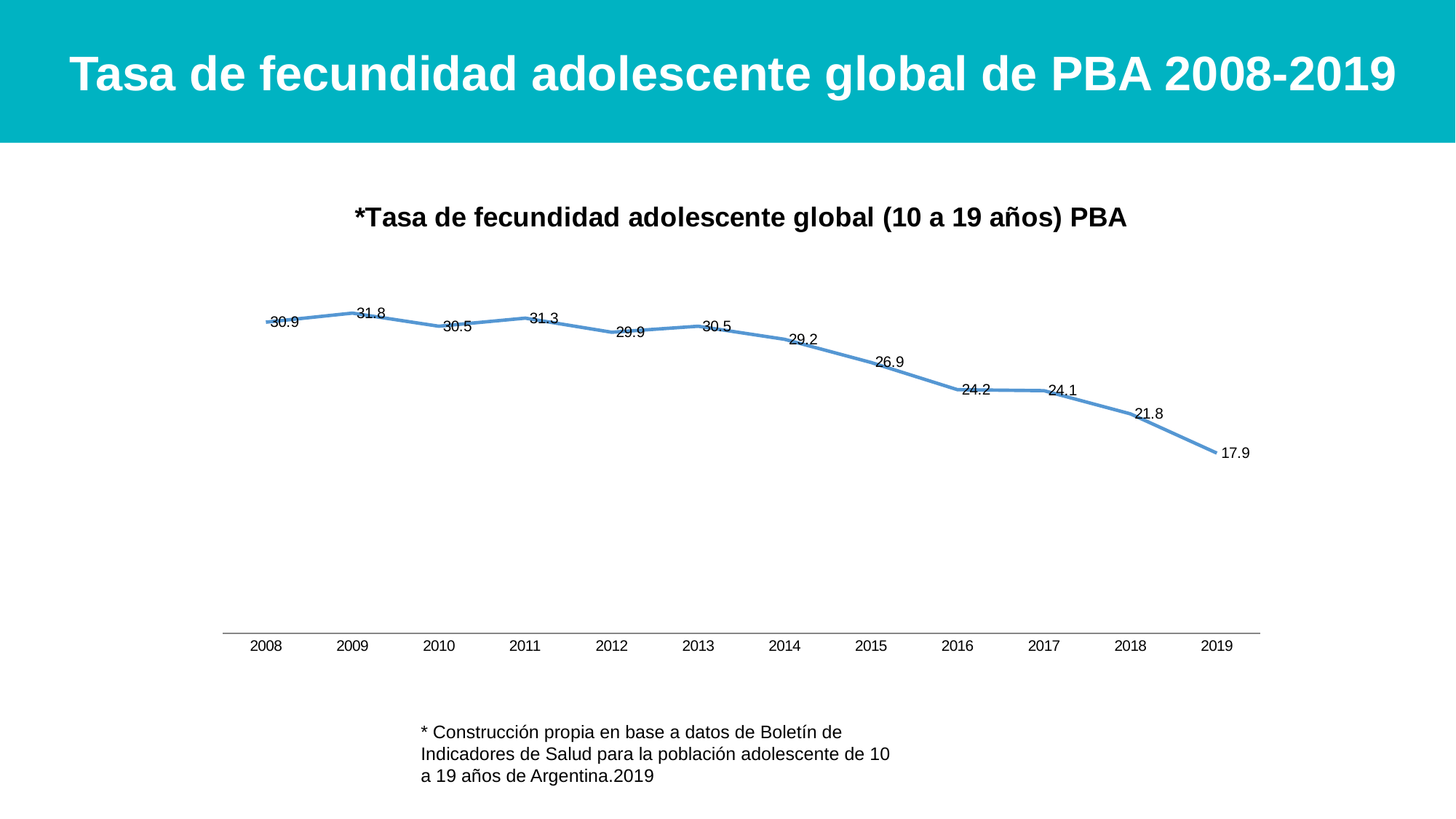
Which year has the lowest value? 2019 Do the values generally rise or fall from 2013 to 2019? Fall What is the difference between the values for 2008 and 2019? 13.0 What kind of chart is shown? Line chart What is the difference between the values for 2015 and 2016? 2.7 How many years are plotted on the x axis? 12 Which year has the highest value? 2009 What is the title of the chart? *Tasa de fecundidad adolescente global (10 a 19 años) PBA What is the value for 2008? 30.9 Which is larger, the value for 2011 or the value for 2012? 2011 What is the value for 2014? 29.2 What is the value for 2019? 17.9